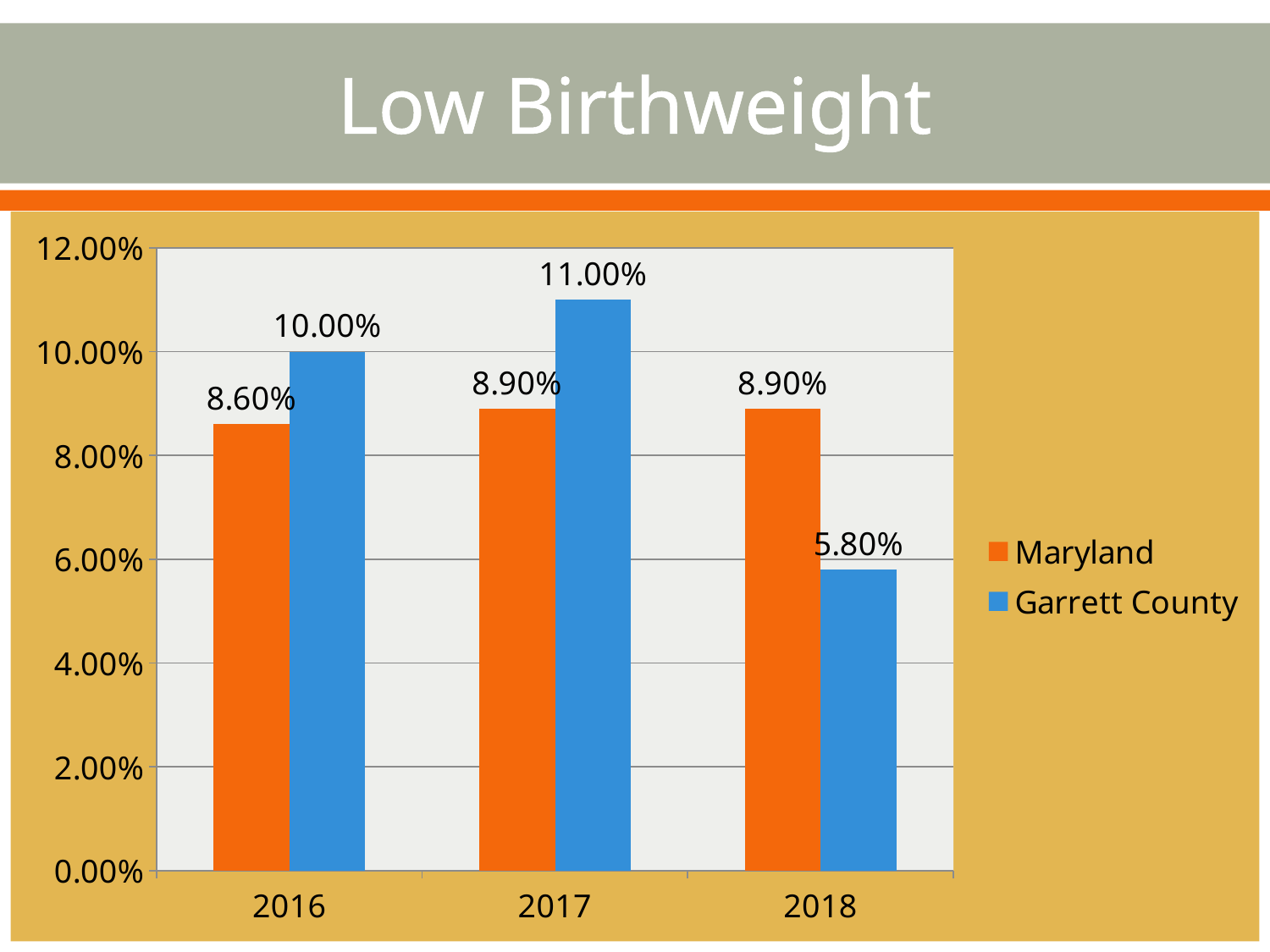
How many series does the legend list? 2 What is the title of the slide? Low Birthweight Which is larger in 2018, the Maryland value or the Garrett County value? Maryland Is the Garrett County value for 2016 greater or less than 8.00%? greater In which year is the Garrett County value highest? 2017 In which year is the Garrett County value lowest? 2018 What is the difference between the Garrett County and Maryland values in 2017? 2.10% What kind of chart is shown on the slide? Bar chart What is the Garrett County value for 2017? 11.00% What is the Maryland value for 2016? 8.60% How many years are shown on the x axis? 3 What is the Garrett County value for 2018? 5.80%